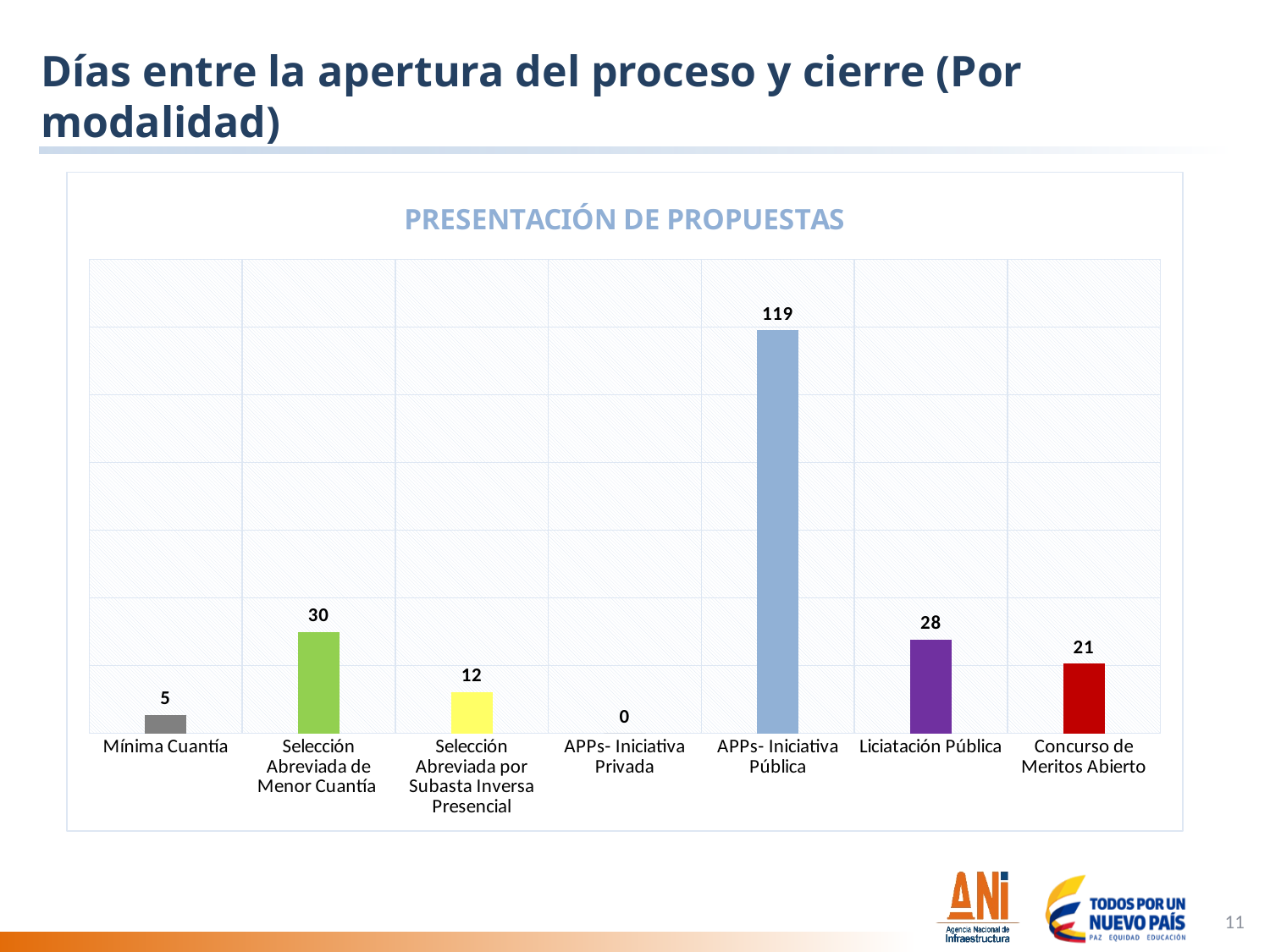
What is the title of the chart? PRESENTACIÓN DE PROPUESTAS What is the value for Mínima Cuantía? 5 What is the difference between the values for APPs- Iniciativa Pública and Licitación Pública? 91 Which category has the lowest value? APPs- Iniciativa Privada What is the value for APPs- Iniciativa Pública? 119 What is the difference between the values for Selección Abreviada de Menor Cuantía and Selección Abreviada por Subasta Inversa Presencial? 18 What kind of chart is shown on the slide? Bar chart What is the value for Licitación Pública? 28 Which is larger, the value for Licitación Pública or the value for Concurso de Meritos Abierto? Licitación Pública What is the value for Concurso de Meritos Abierto? 21 Which category has the highest value? APPs- Iniciativa Pública How many categories are shown on the x axis? 7